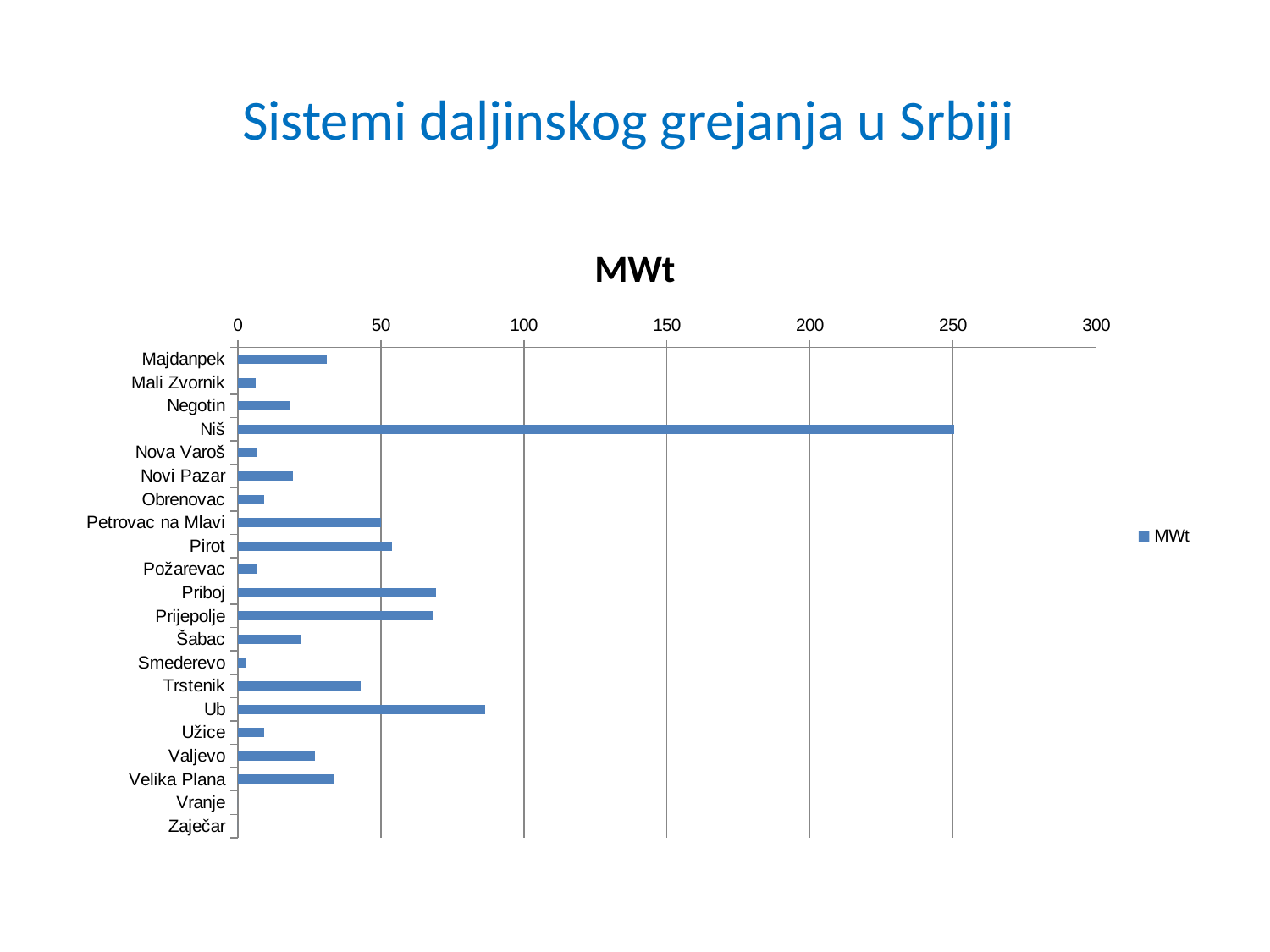
Is the value for Ub greater or less than 50? greater How many series does the legend list? 1 Is the value for Niš greater or less than 200? greater Is the value for Majdanpek greater or less than 50? less What kind of chart is shown on the slide? bar chart How many categories are shown on the vertical axis of the chart? 21 Which category has the highest value in the chart? Niš Which has the larger value, Velika Plana or Negotin? Velika Plana Which has the larger value, Ub or Priboj? Ub